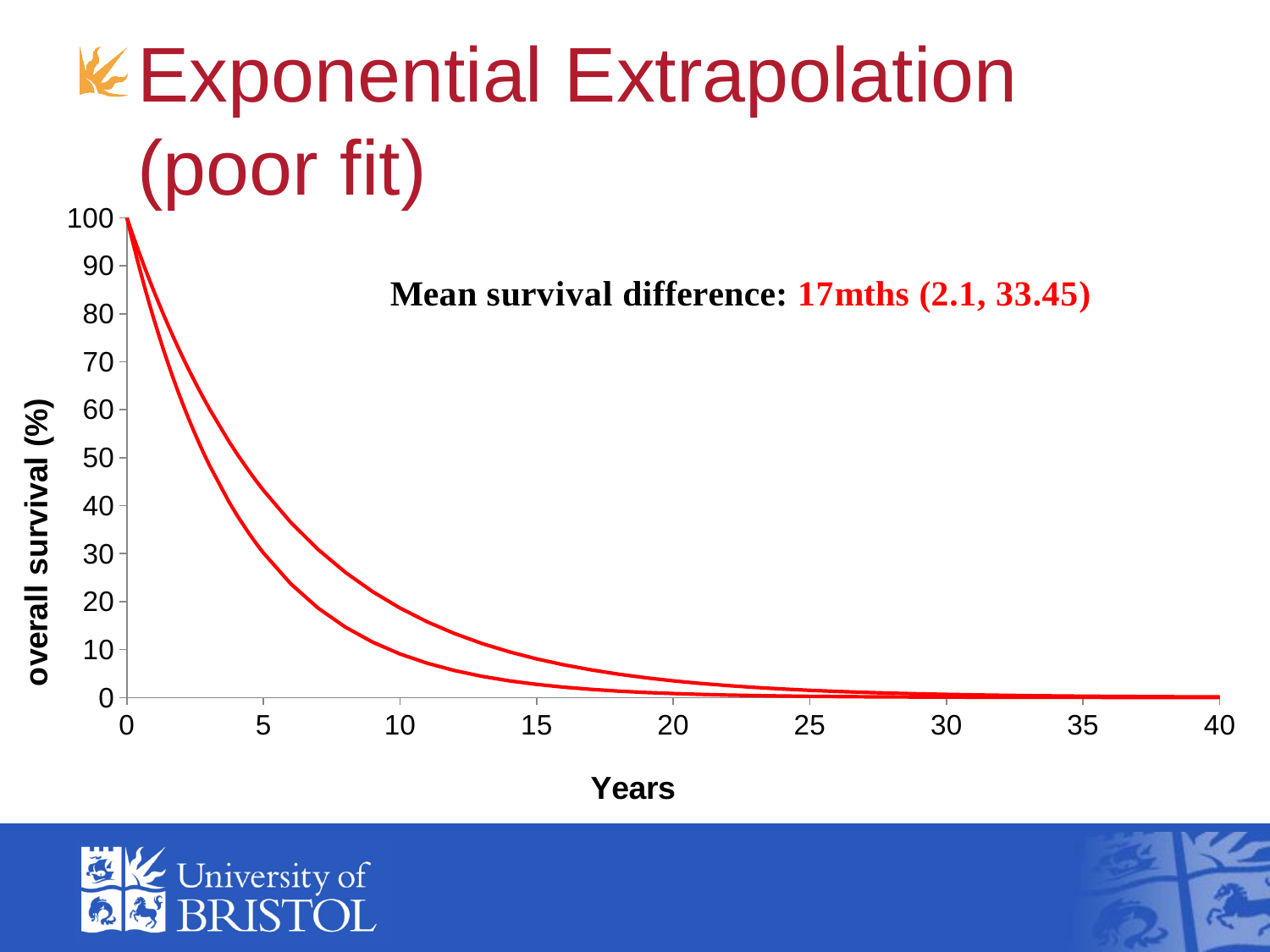
What kind of chart is shown on the slide? line chart Is the value of the upper curve at 20 years greater or less than 10? less What is the overall survival value of both curves at year 0? 100 Is the value of the upper curve at 10 years greater or less than 10? greater Do the survival curves rise or fall as the number of years increases? fall Is the value of the lower curve at 10 years greater or less than 20? less What is the highest value shown on the x axis (Years)? 40 How many survival curves are plotted on the chart? 2 What mean survival difference is stated on the chart? 17mths (2.1, 33.45) What is the label of the y axis? overall survival (%)